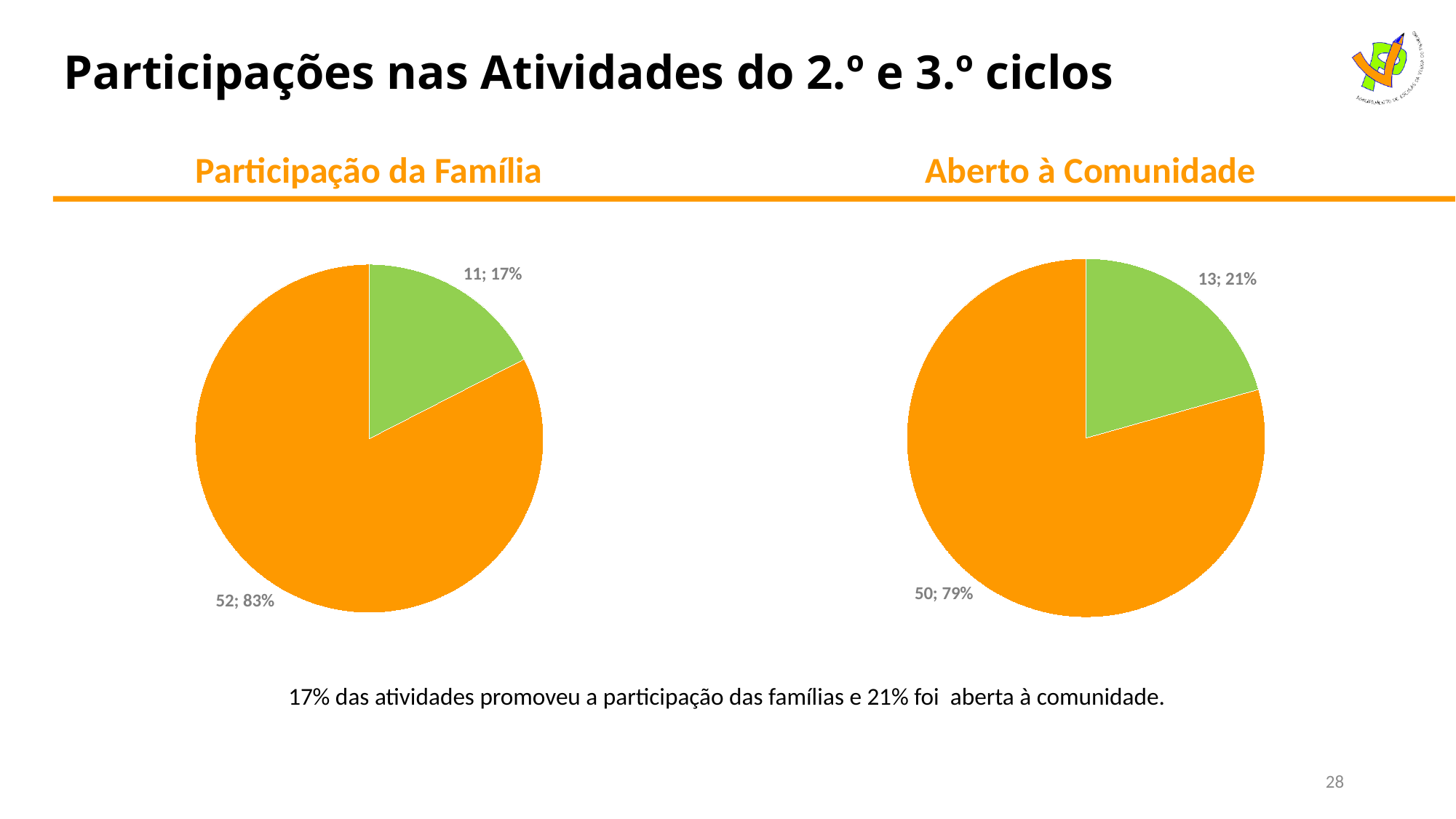
What is the title of the pie chart on the right side of the slide? Aberto à Comunidade How many slices does the "Aberto à Comunidade" pie chart have? 2 In the "Participação da Família" chart, what is the data label on the orange slice? 52; 83% In the "Participação da Família" chart, what is the data label on the green slice? 11; 17% In the "Participação da Família" chart, what share of the pie does the green slice represent? 17% In the "Aberto à Comunidade" chart, what is the data label on the orange slice? 50; 79% In the "Aberto à Comunidade" chart, what is the data label on the green slice? 13; 21% What kind of chart is the "Participação da Família" chart? pie chart In the "Participação da Família" chart, which slice is larger, the green one or the orange one? the orange one In the "Participação da Família" chart, what is the total of the two slice counts? 63 In the "Aberto à Comunidade" chart, what share of the pie does the orange slice represent? 79% In the "Aberto à Comunidade" chart, what is the difference between the count of the orange slice and the count of the green slice? 37